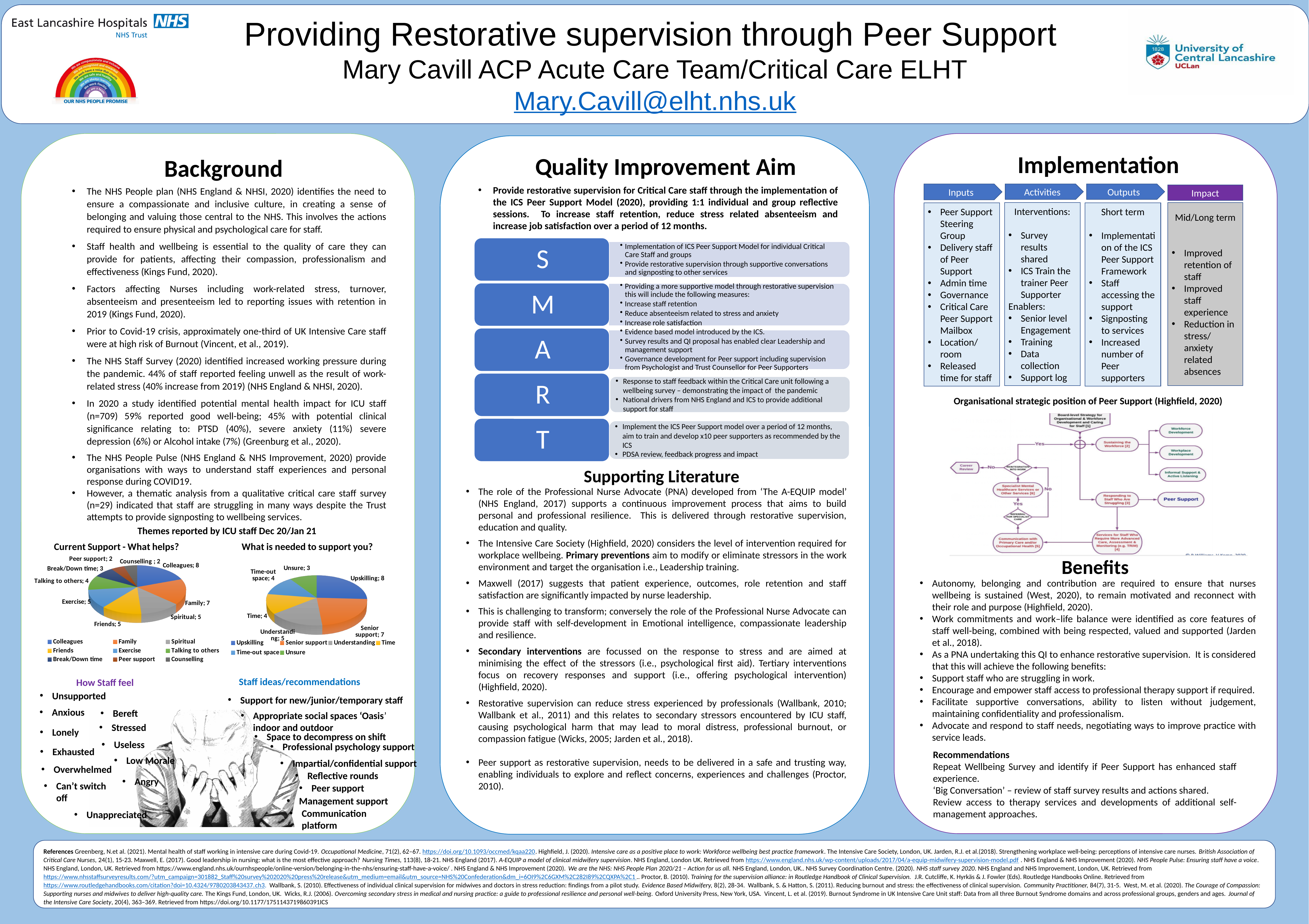
In the 'Current Support - What helps?' chart, what is the value for Family? 7 In the 'Current Support - What helps?' chart, what is the difference between the values for Colleagues and Break/Down time? 5 In the 'Current Support - What helps?' chart, which category has the highest value? Colleagues In the 'What is needed to support you?' chart, what is the value for Senior support? 7 In the 'What is needed to support you?' chart, which is larger: Understanding or Time? Understanding In the 'What is needed to support you?' chart, which category has the lowest value? Unsure In the 'Current Support - What helps?' chart, how many categories are shown in the legend? 9 What kind of chart is 'Current Support - What helps?'? Pie chart In the 'What is needed to support you?' chart, how many categories are shown? 6 In the 'What is needed to support you?' chart, what is the difference between the values for Upskilling and Unsure? 5 In the 'Current Support - What helps?' chart, what is the value for Colleagues? 8 In the 'What is needed to support you?' chart, what is the value for Upskilling? 8